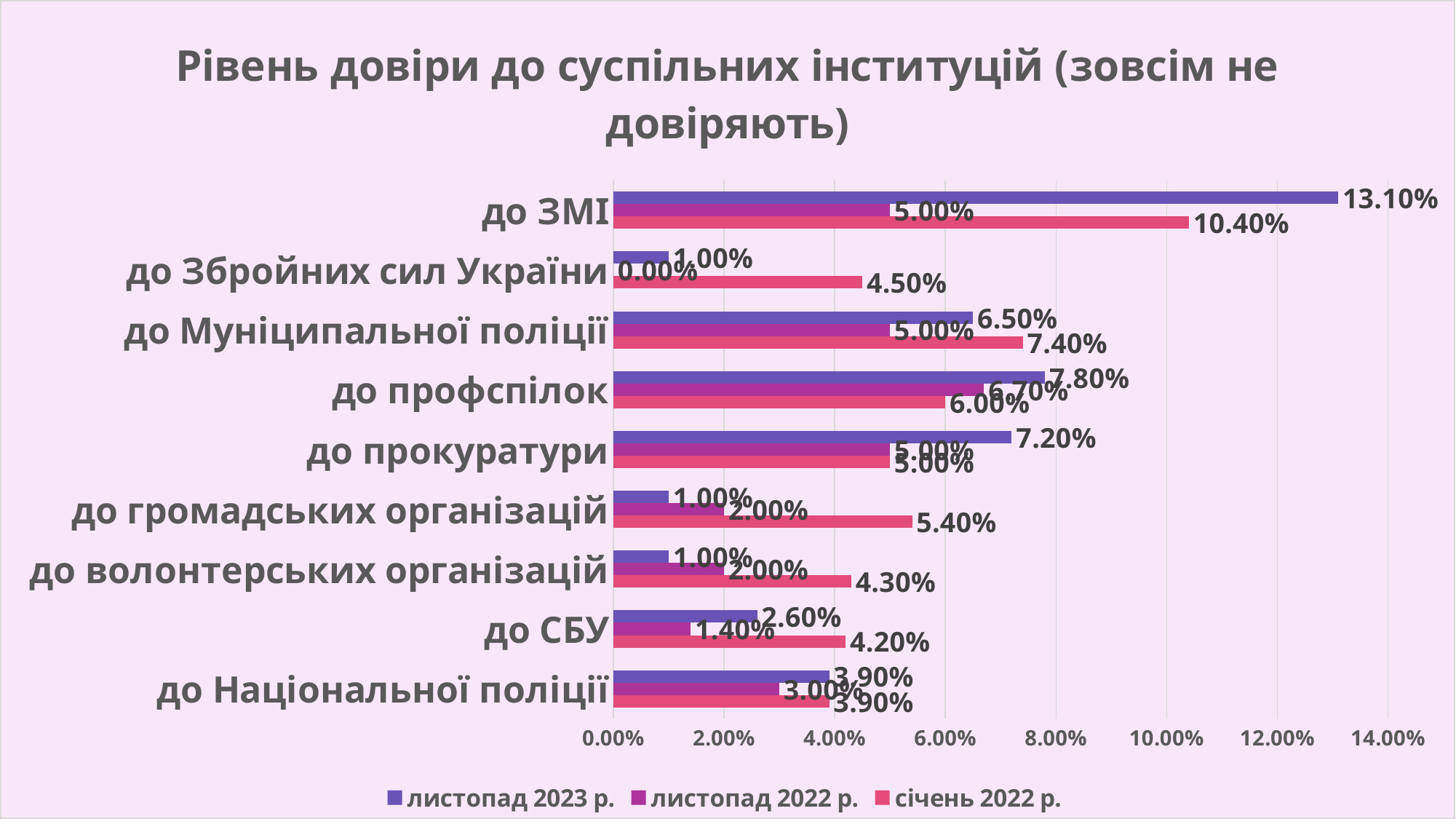
How many series does the legend list? 3 What is the difference between the листопад 2023 р. and січень 2022 р. values for до ЗМІ? 2.70% Which category has the highest value in the листопад 2023 р. series? до ЗМІ Which is larger for до Муніципальної поліції: the листопад 2023 р. value or the січень 2022 р. value? січень 2022 р. How many categories are shown on the chart? 9 Is the листопад 2023 р. value for до ЗМІ greater or less than 12.00%? greater What is the value for до СБУ in the листопад 2022 р. series? 1.40% Which category has the lowest value in the листопад 2022 р. series? до Збройних сил України What kind of chart is shown on the slide? bar chart What is the value for до Збройних сил України in the січень 2022 р. series? 4.50% What is the value for до ЗМІ in the листопад 2023 р. series? 13.10% What is the value for до ЗМІ in the січень 2022 р. series? 10.40%